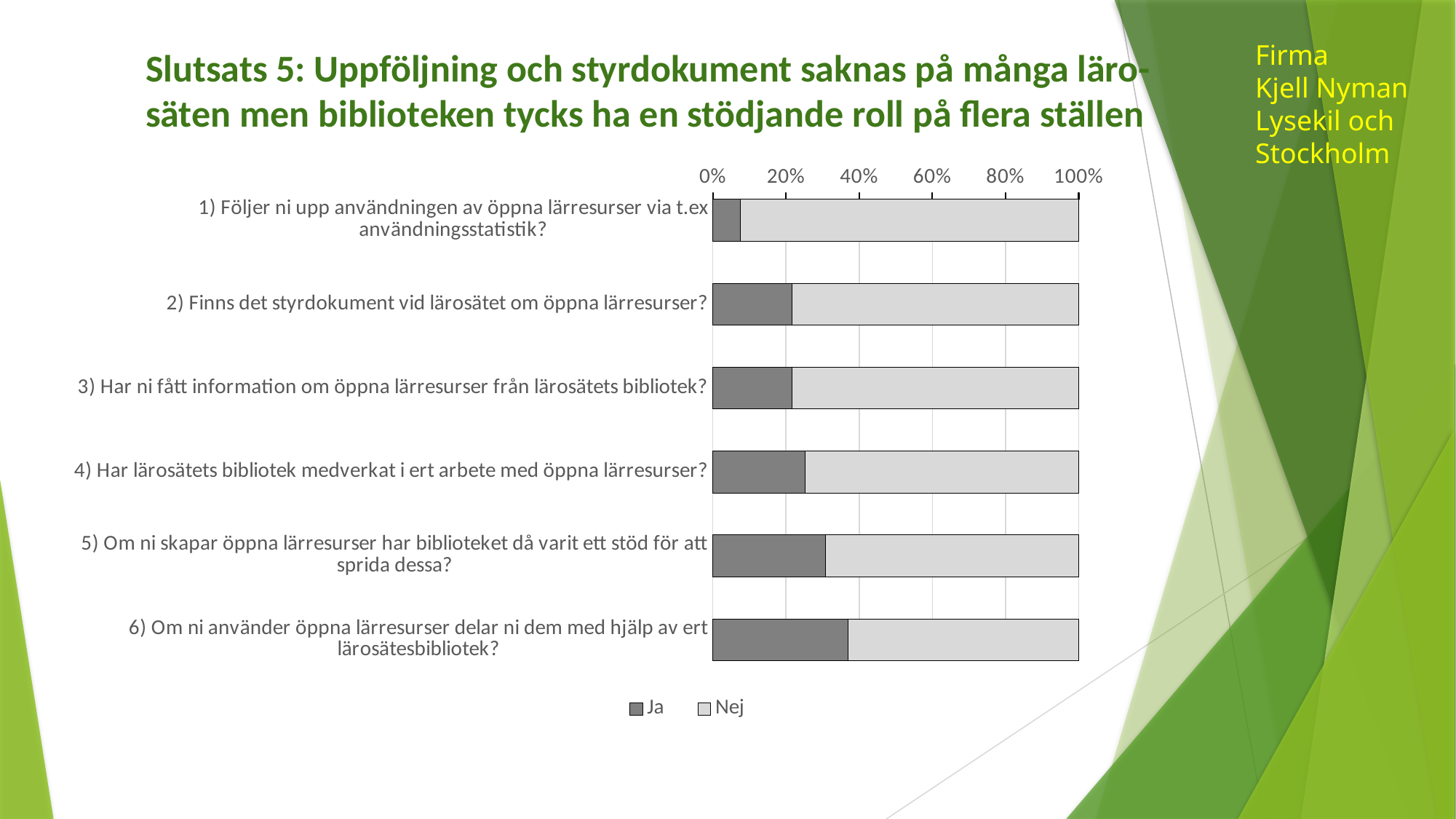
Is the 'Ja' share for question 5 (har biblioteket då varit ett stöd för att sprida dessa) greater or less than 20%? greater How many series does the chart legend list? 2 Which question has the smallest 'Ja' share? 1) Följer ni upp användningen av öppna lärresurser via t.ex användningsstatistik? Is the 'Nej' share for question 6 greater or less than 60%? greater What are the two series named in the legend? Ja and Nej How many questions (categories) are plotted in the chart? 6 Which has a larger 'Ja' share: question 5 or question 2? Question 5 What is the total of each stacked bar, as shown by where the bars end on the axis? 100% Is the 'Ja' share for question 1 (Följer ni upp användningen av öppna lärresurser) greater or less than 20%? less What kind of chart is shown on the slide? Stacked bar chart Which question has the largest 'Ja' share? 6) Om ni använder öppna lärresurser delar ni dem med hjälp av ert lärosätesbibliotek?